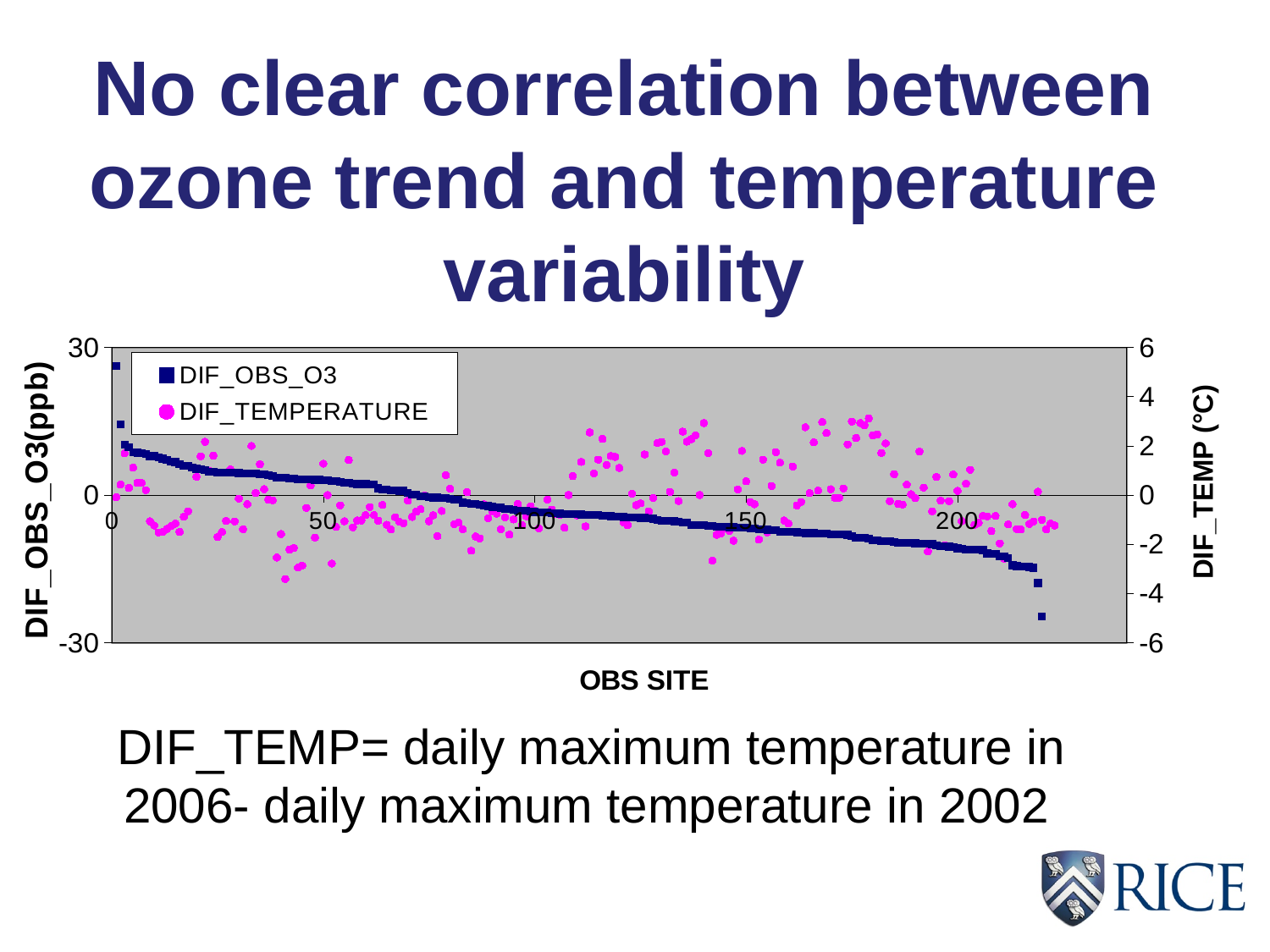
How many series does the chart legend list? 2 What is the maximum value shown on the right-hand DIF_TEMP (°C) axis? 6 Is the DIF_OBS_O3 value at observation site 200 greater or less than 0? less Is the DIF_OBS_O3 value at the first observation site (near 0 on the x axis) greater or less than 0? greater What is the title of the x axis of the chart? OBS SITE What kind of chart is shown on the slide? scatter chart Is the DIF_OBS_O3 value at observation site 50 greater or less than 0? greater What are the two series named in the chart legend? DIF_OBS_O3 and DIF_TEMPERATURE Which series has the larger value at observation site 0: DIF_OBS_O3 (left axis, ppb) or DIF_TEMPERATURE (right axis, °C)? DIF_OBS_O3 Do the DIF_OBS_O3 values rise or fall as the OBS SITE number increases along the x axis? fall